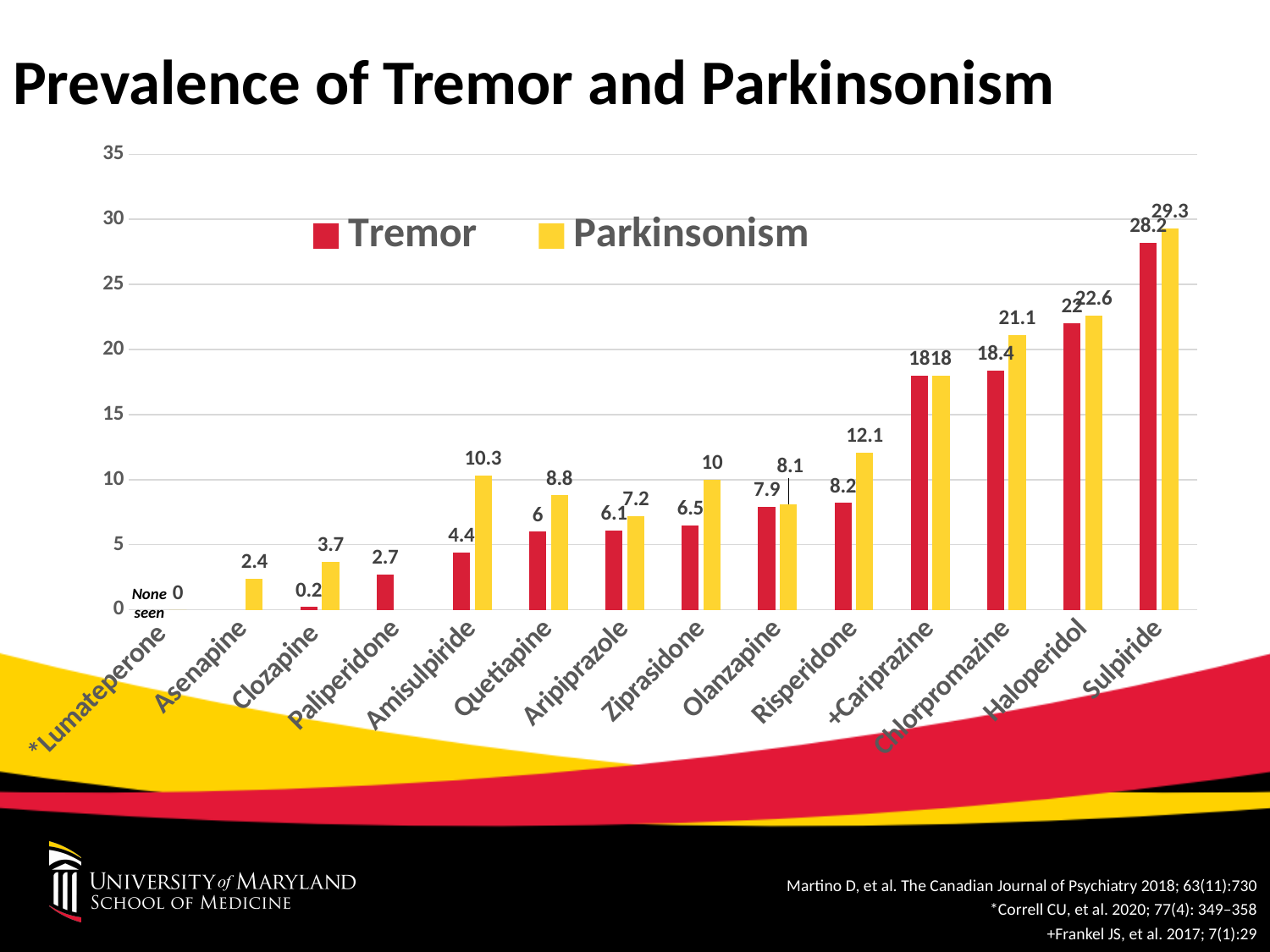
Which is larger for Risperidone, the Tremor value or the Parkinsonism value? Parkinsonism What is the Tremor value for Chlorpromazine? 18.4 Which drug has the highest Parkinsonism value? Sulpiride What is the Parkinsonism value for Amisulpiride? 10.3 How many drugs are shown on the x axis? 14 Do the Parkinsonism values generally rise or fall from left to right along the x axis? Rise What is the Parkinsonism value for Risperidone? 12.1 What kind of chart is shown on the slide? Bar chart Which drug has the highest Tremor value? Sulpiride How many series does the legend list? 2 What is the Tremor value for Clozapine? 0.2 What is the difference between the Parkinsonism and Tremor values for Amisulpiride? 5.9